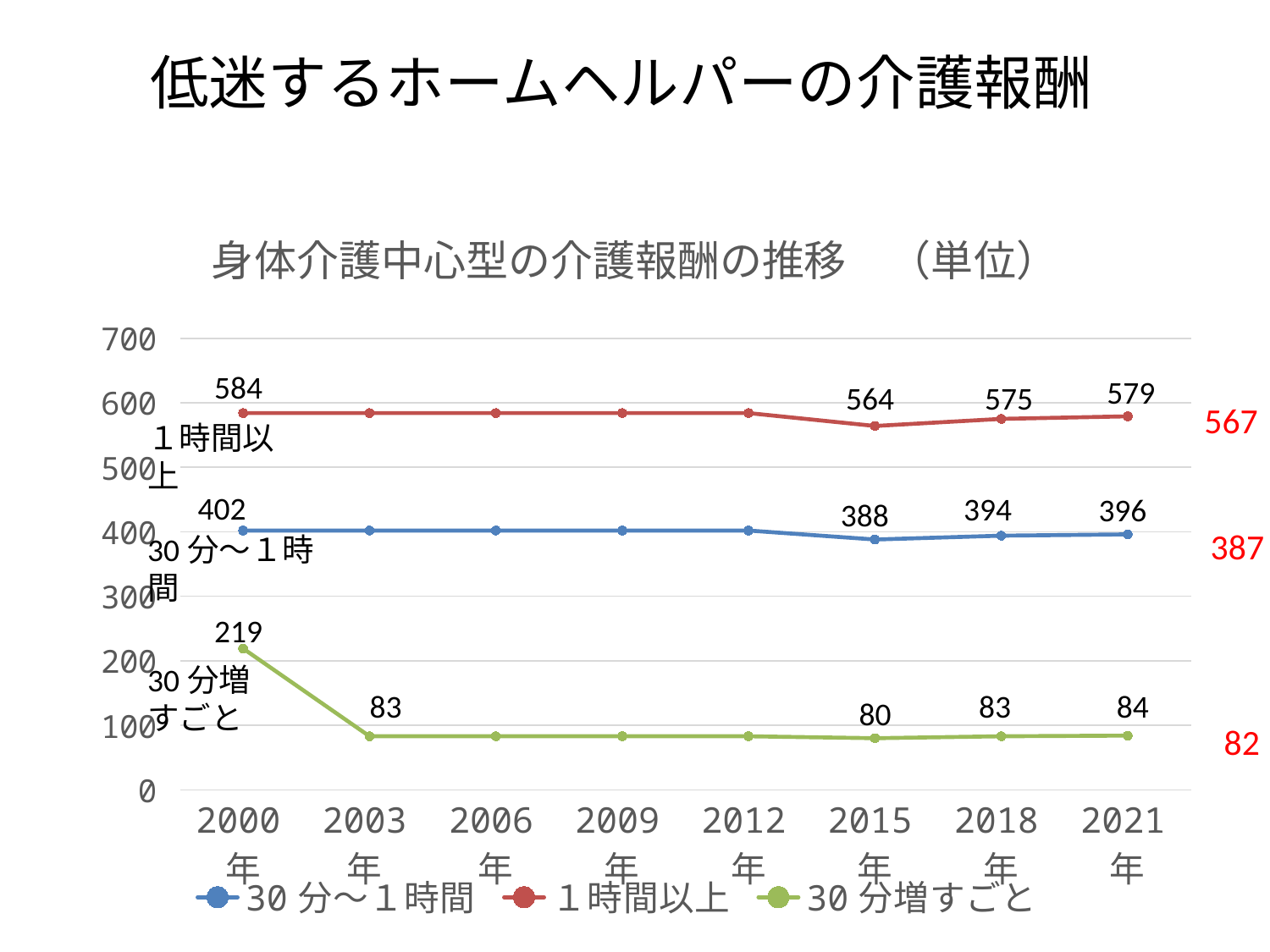
In which year is the 30分増すごと series highest? 2000年 How many series does the legend list? 3 What is the difference between the 30分増すごと value in 2000年 and its value in 2003年? 136 Is the value of the 30分～1時間 series in 2006年 greater or less than 300? greater Which is larger: the 30分～1時間 value in 2018年 or in 2021年? 2021年 In which year is the 1時間以上 series lowest? 2015年 What is the value of the 30分増すごと series in 2021年? 84 What is the difference between the 1時間以上 value in 2000年 and its value in 2015年? 20 What kind of chart is shown on the slide? line chart What is the value of the 30分～1時間 series in 2015年? 388 What is the value of the 30分増すごと series in 2003年? 83 What is the value of the 1時間以上 series in 2000年? 584